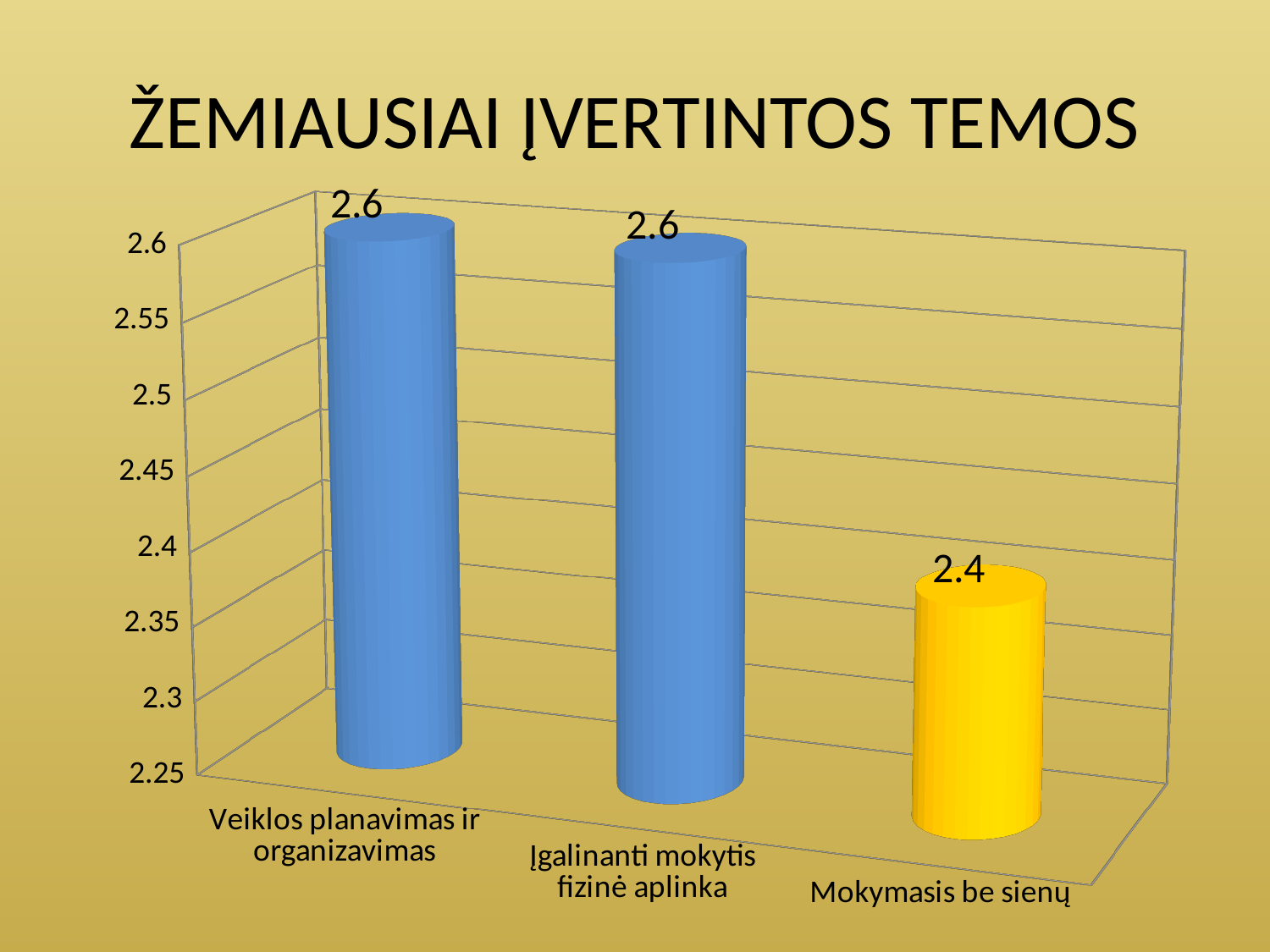
What is the difference between the values for Veiklos planavimas ir organizavimas and Mokymasis be sienų? 0.2 What is the title of the slide? ŽEMIAUSIAI ĮVERTINTOS TEMOS What is the value for Mokymasis be sienų? 2.4 Is the value for Veiklos planavimas ir organizavimas greater or less than 2.5? greater What is the value for Veiklos planavimas ir organizavimas? 2.6 Is the value for Mokymasis be sienų greater or less than 2.5? less Which category has the lowest value? Mokymasis be sienų What is the value for Įgalinanti mokytis fizinė aplinka? 2.6 Which is larger, the value for Įgalinanti mokytis fizinė aplinka or the value for Mokymasis be sienų? Įgalinanti mokytis fizinė aplinka How many categories are shown in the chart? 3 What colour is the bar for Mokymasis be sienų? yellow What kind of chart is shown on the slide? bar chart